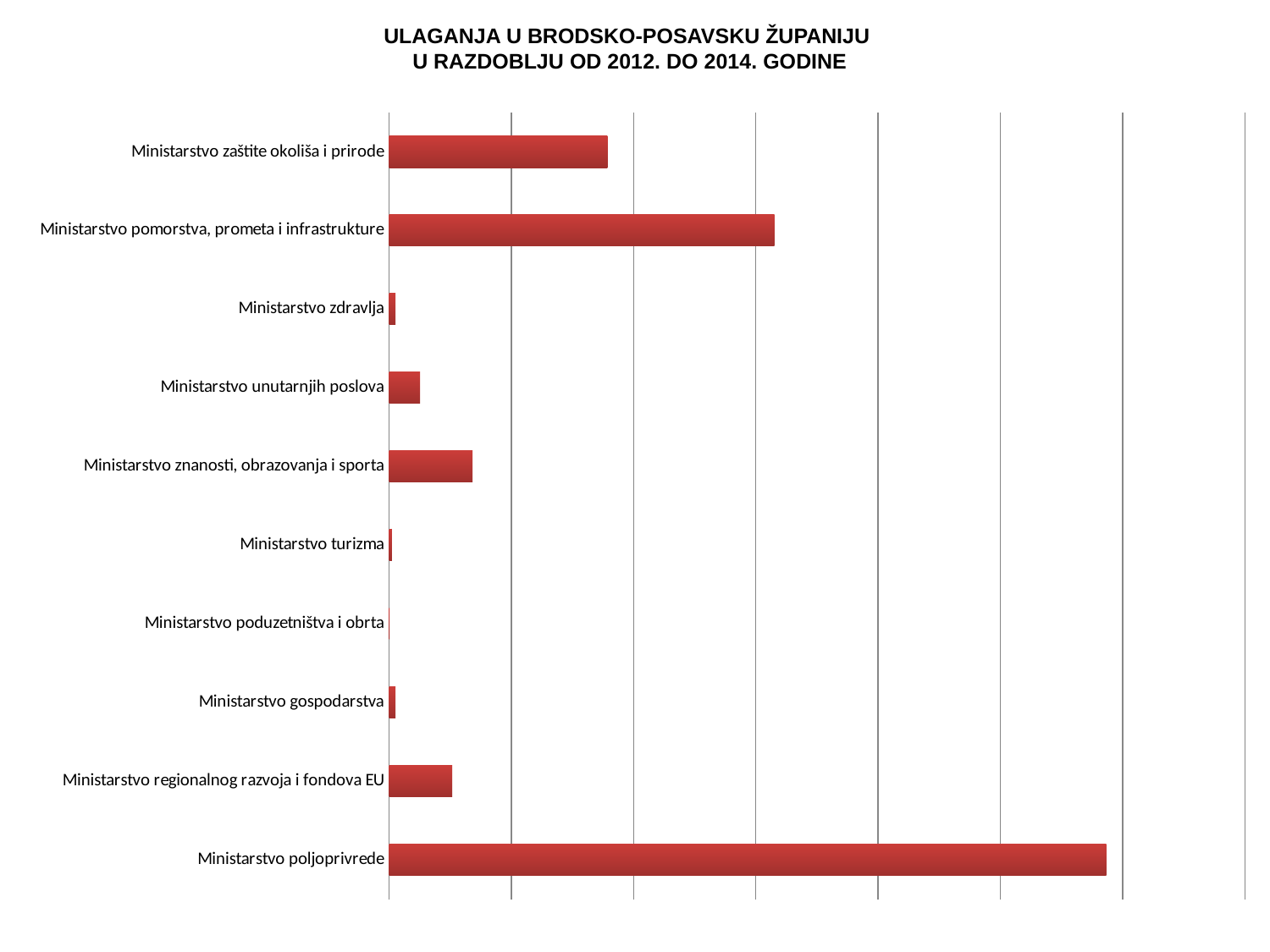
Which has the larger value: Ministarstvo znanosti, obrazovanja i sporta or Ministarstvo unutarnjih poslova? Ministarstvo znanosti, obrazovanja i sporta What colour are the bars in the chart? red How many ministries (categories) are shown in the chart? 10 Which has the larger value: Ministarstvo regionalnog razvoja i fondova EU or Ministarstvo turizma? Ministarstvo regionalnog razvoja i fondova EU Which ministry has the lowest value in the chart? Ministarstvo poduzetništva i obrta Which has the larger value: Ministarstvo pomorstva, prometa i infrastrukture or Ministarstvo zaštite okoliša i prirode? Ministarstvo pomorstva, prometa i infrastrukture What is the title of the chart? ULAGANJA U BRODSKO-POSAVSKU ŽUPANIJU U RAZDOBLJU OD 2012. DO 2014. GODINE What kind of chart is shown on the slide? bar chart Which ministry has the second-highest value in the chart? Ministarstvo pomorstva, prometa i infrastrukture Which ministry has the highest value in the chart? Ministarstvo poljoprivrede